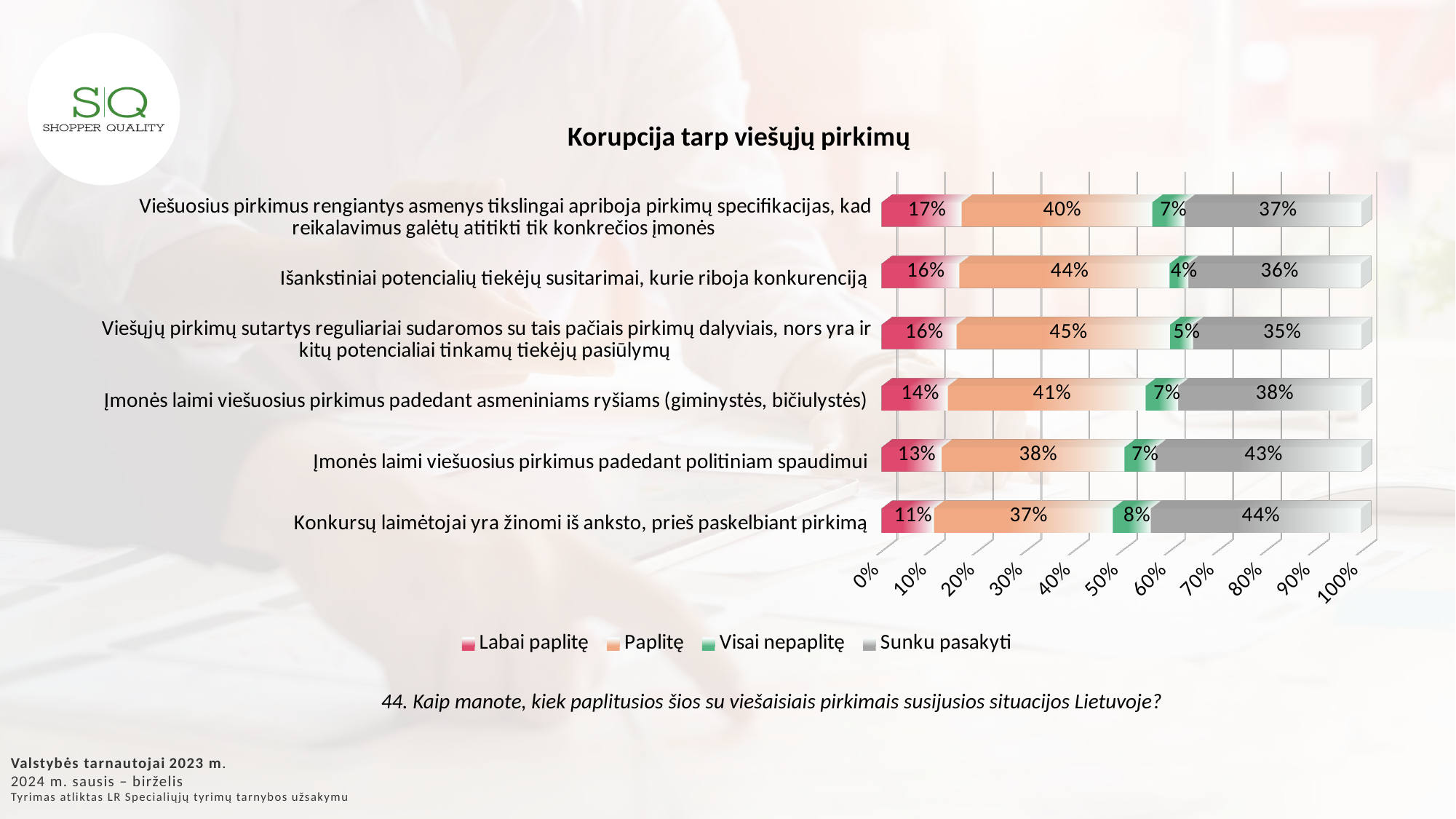
What is the 'Paplitę' value for 'Išankstiniai potencialių tiekėjų susitarimai, kurie riboja konkurenciją'? 44% Which category has the highest 'Labai paplitę' value? Viešuosius pirkimus rengiantys asmenys tikslingai apriboja pirkimų specifikacijas, kad reikalavimus galėtų atitikti tik konkrečios įmonės Which category has the lowest 'Visai nepaplitę' value? Išankstiniai potencialių tiekėjų susitarimai, kurie riboja konkurenciją Which is larger: the 'Paplitę' value for 'Įmonės laimi viešuosius pirkimus padedant asmeniniams ryšiams (giminystės, bičiulystės)' or for 'Įmonės laimi viešuosius pirkimus padedant politiniam spaudimui'? Įmonės laimi viešuosius pirkimus padedant asmeniniams ryšiams (giminystės, bičiulystės) What is the combined total of 'Labai paplitę' and 'Paplitę' for 'Viešųjų pirkimų sutartys reguliariai sudaromos su tais pačiais pirkimų dalyviais, nors yra ir kitų potencialiai tinkamų tiekėjų pasiūlymų'? 61% What is the 'Labai paplitę' value for 'Konkursų laimėtojai yra žinomi iš anksto, prieš paskelbiant pirkimą'? 11% What is the difference between the 'Sunku pasakyti' values for 'Konkursų laimėtojai yra žinomi iš anksto, prieš paskelbiant pirkimą' and 'Viešųjų pirkimų sutartys reguliariai sudaromos su tais pačiais pirkimų dalyviais, nors yra ir kitų potencialiai tinkamų tiekėjų pasiūlymų'? 9% How many categories (statements) are shown in the chart? 6 What type of chart is shown on the slide? Stacked bar chart What is the 'Sunku pasakyti' value for 'Įmonės laimi viešuosius pirkimus padedant politiniam spaudimui'? 43% How many series does the legend list? 4 What is the title of the chart? Korupcija tarp viešųjų pirkimų